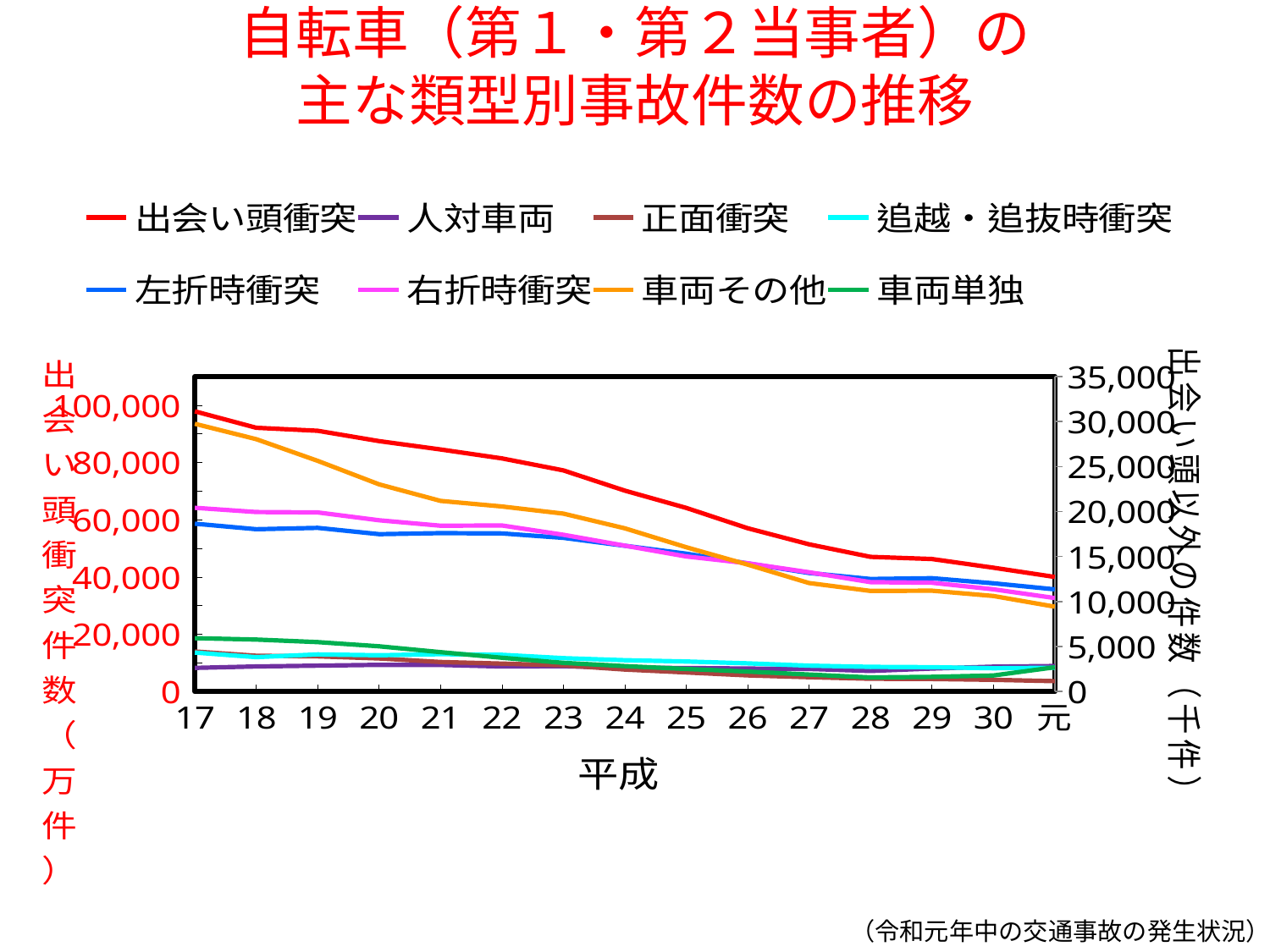
What kind of chart is shown on the slide? line chart How many series does the legend list? 8 Is the value for 車両その他 at 元 greater or less than 15,000 on the right axis? less Is the value for 出会い頭衝突 at 平成17 greater or less than 80,000 on the left axis? greater Is the value for 車両その他 at 平成17 greater or less than 25,000 on the right axis? greater How many years (points) are shown along the x axis? 15 Does the 出会い頭衝突 line rise or fall from 平成17 to 元? fall Does the 車両その他 line rise or fall across the x axis? fall At 平成17, which is larger: 車両その他 or 右折時衝突? 車両その他 What colour is the 出会い頭衝突 line in the legend? red Among the series plotted on the right axis, which has the lowest value at 元? 正面衝突